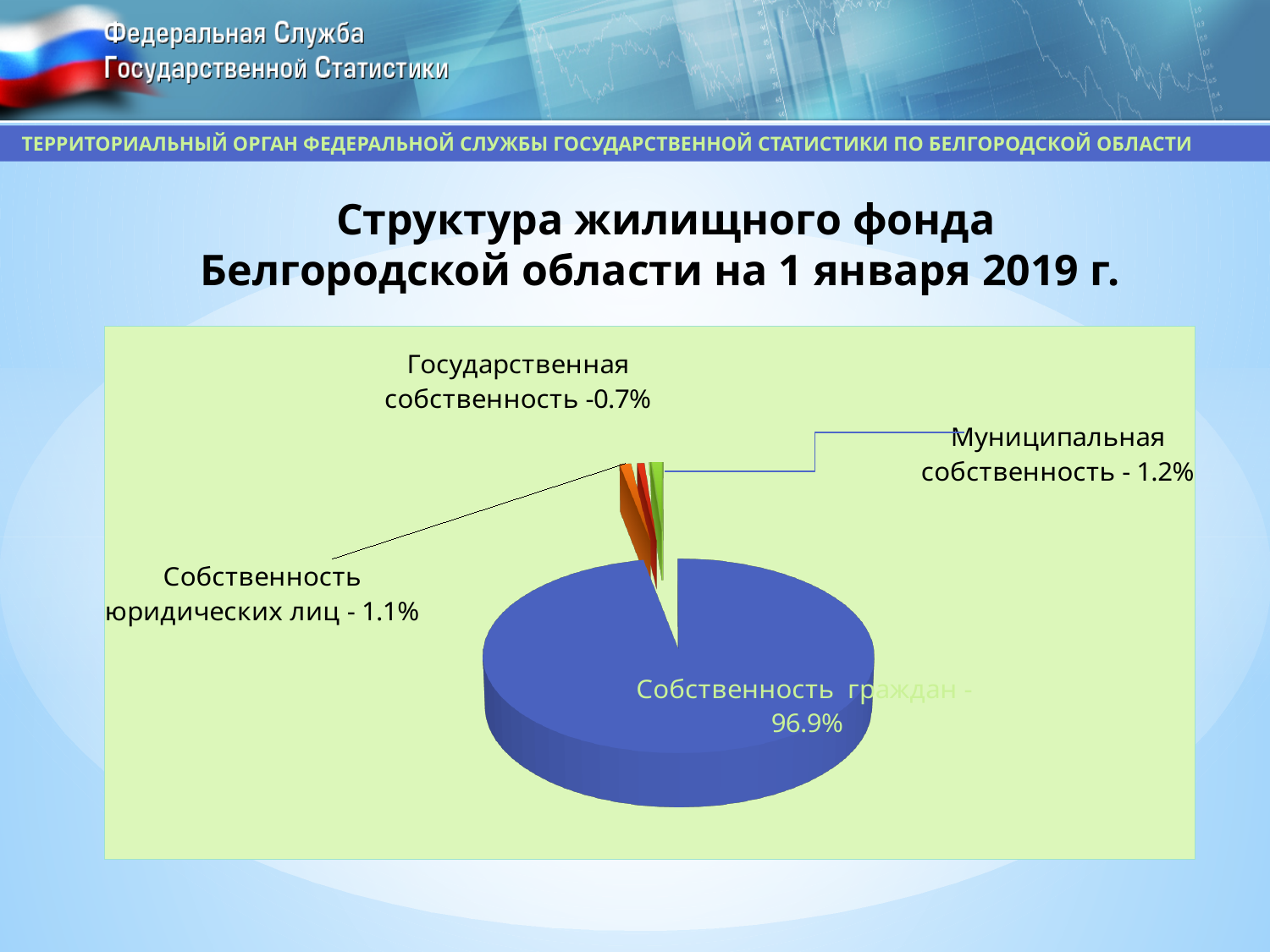
Which is larger: the share of Муниципальная собственность or Собственность юридических лиц? Муниципальная собственность What share is shown for Собственность юридических лиц? 1.1% How many slices does the pie chart have? 4 What share is shown for Государственная собственность? 0.7% What share is shown for Муниципальная собственность? 1.2% What type of chart is shown on the slide? Pie chart Which category has the smallest share of the pie? Государственная собственность What share of the housing stock is Собственность граждан? 96.9% What is the difference between the shares of Муниципальная собственность and Государственная собственность? 0.5% What colour is the slice for Собственность граждан? Blue What is the title of the chart on the slide? Структура жилищного фонда Белгородской области на 1 января 2019 г. Which category has the largest share of the pie? Собственность граждан